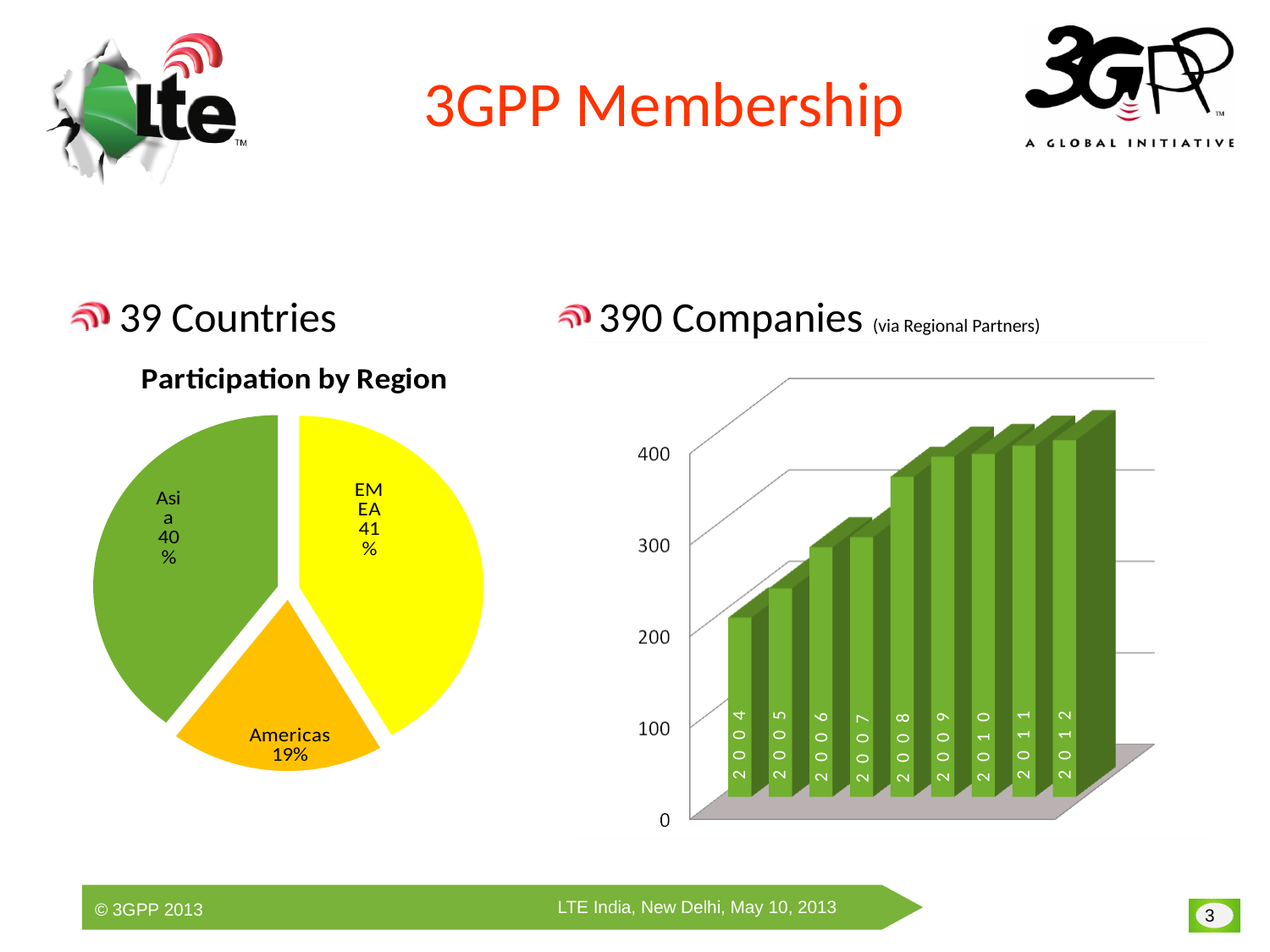
In the bar chart on the right, is the value for 2004 greater or less than 300? less In the bar chart on the right, do the values generally rise or fall from 2004 to 2012? rise In the Participation by Region pie chart, what share does EMEA have? 41% In the Participation by Region pie chart, how many regions are shown? 3 In the Participation by Region pie chart, what share does the Americas have? 19% In the Participation by Region pie chart, which region has the smallest share? Americas In the Participation by Region pie chart, which region has the largest share? EMEA What kind of chart is the chart on the right side of the slide, under '390 Companies'? Bar chart In the Participation by Region pie chart, what share does Asia have? 40% In the Participation by Region pie chart, how many percentage points larger is EMEA's share than the Americas' share? 22% In the bar chart on the right, which year has the lowest value? 2004 In the bar chart on the right, how many years are shown on the x axis? 9